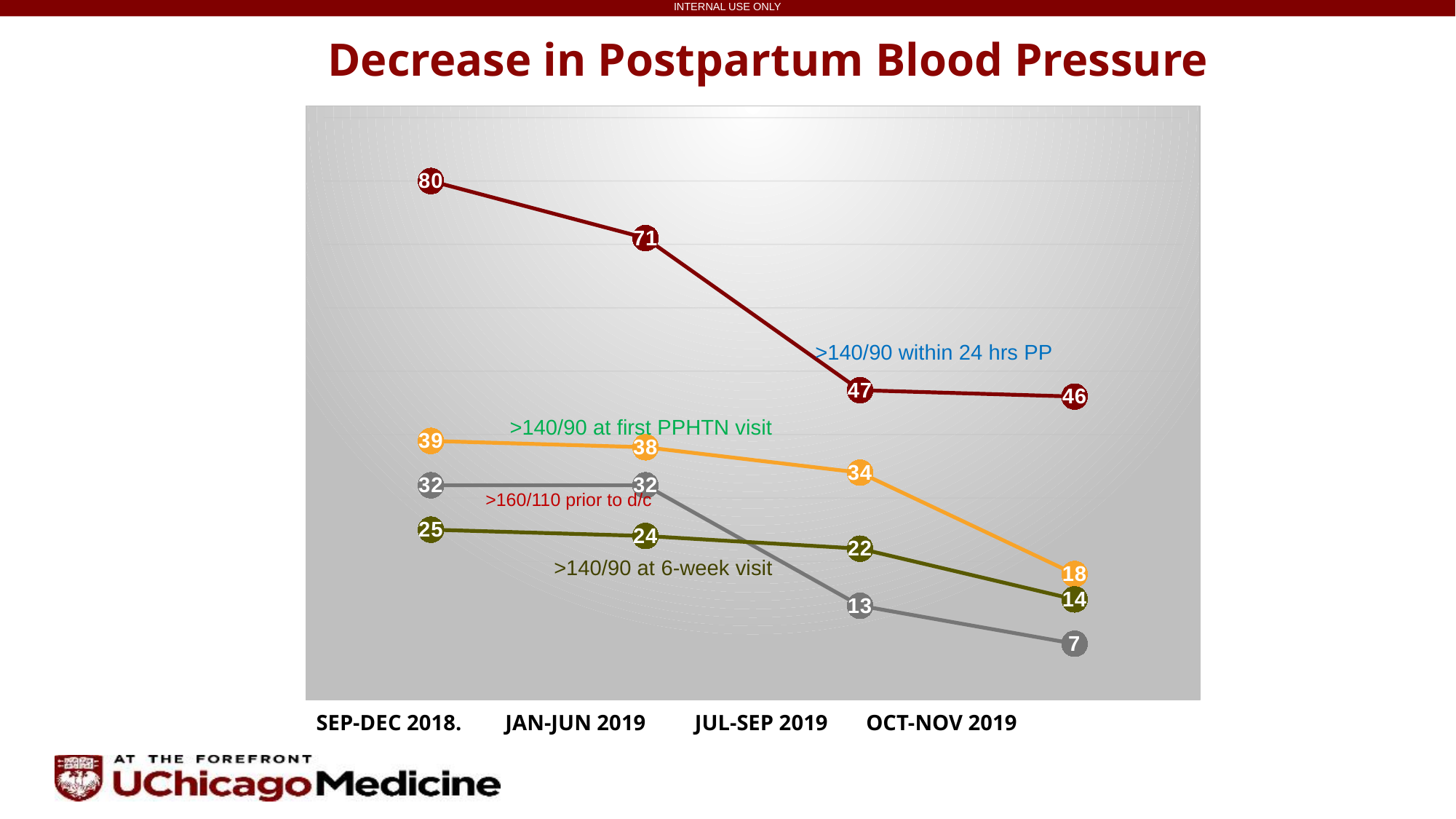
What is the value of the '>140/90 at 6-week visit' series for JAN-JUN 2019? 24 What type of chart is shown on the slide? line chart Which period has the lowest value for the '>160/110 prior to d/c' series? OCT-NOV 2019 What is the value of the '>160/110 prior to d/c' series for JUL-SEP 2019? 13 What is the difference between the '>140/90 within 24 hrs PP' values for JAN-JUN 2019 and JUL-SEP 2019? 24 Which is larger for JUL-SEP 2019: the '>140/90 at first PPHTN visit' value or the '>140/90 at 6-week visit' value? >140/90 at first PPHTN visit Does the '>140/90 within 24 hrs PP' series rise or fall from SEP-DEC 2018 to OCT-NOV 2019? fall Which period has the highest value for the '>140/90 within 24 hrs PP' series? SEP-DEC 2018 How many time periods are shown on the x axis? 4 How many lines are plotted on the chart? 4 What is the value of the '>140/90 at first PPHTN visit' series for OCT-NOV 2019? 18 What is the value of the '>140/90 within 24 hrs PP' series for SEP-DEC 2018? 80